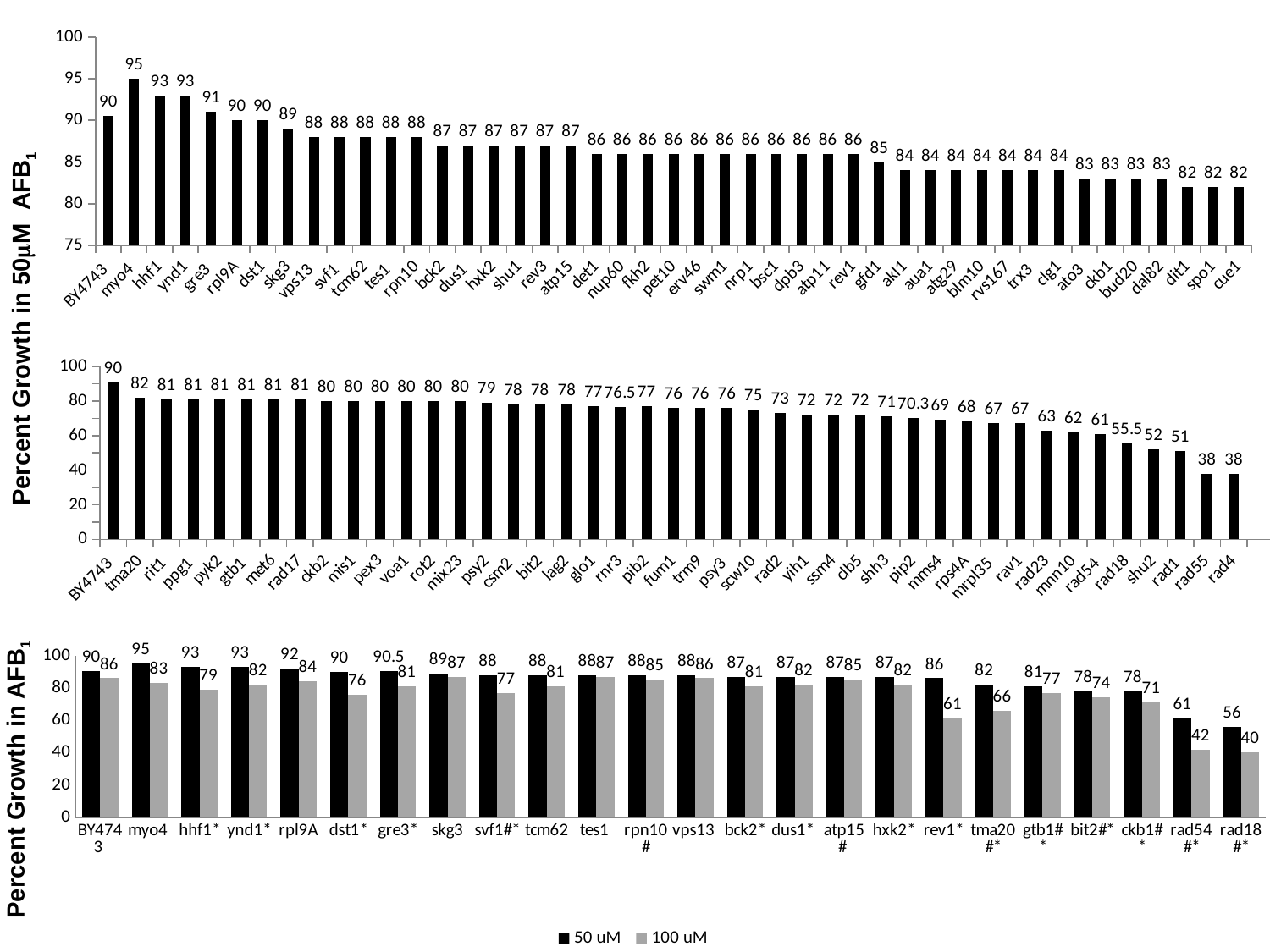
In the top chart, do the values generally rise or fall from left to right along the x axis? fall In the bottom chart, what is the difference between the 50 uM and 100 uM values for rad54#*? 19 In the middle chart, which category has the highest value? BY4743 In the top chart, what is the value for BY4743? 90 In the middle chart, what is the value for rad1? 51 In the top chart, what is the percent growth value for myo4? 95 In the middle chart, what is the value for tma20? 82 In the top chart, which category has the highest value? myo4 In the bottom chart, what is the 100 uM value for rev1*? 61 What type of chart is the bottom chart? bar chart How many series does the legend of the bottom chart list? 2 In the middle chart, is the value for rad4 greater or less than 40? less